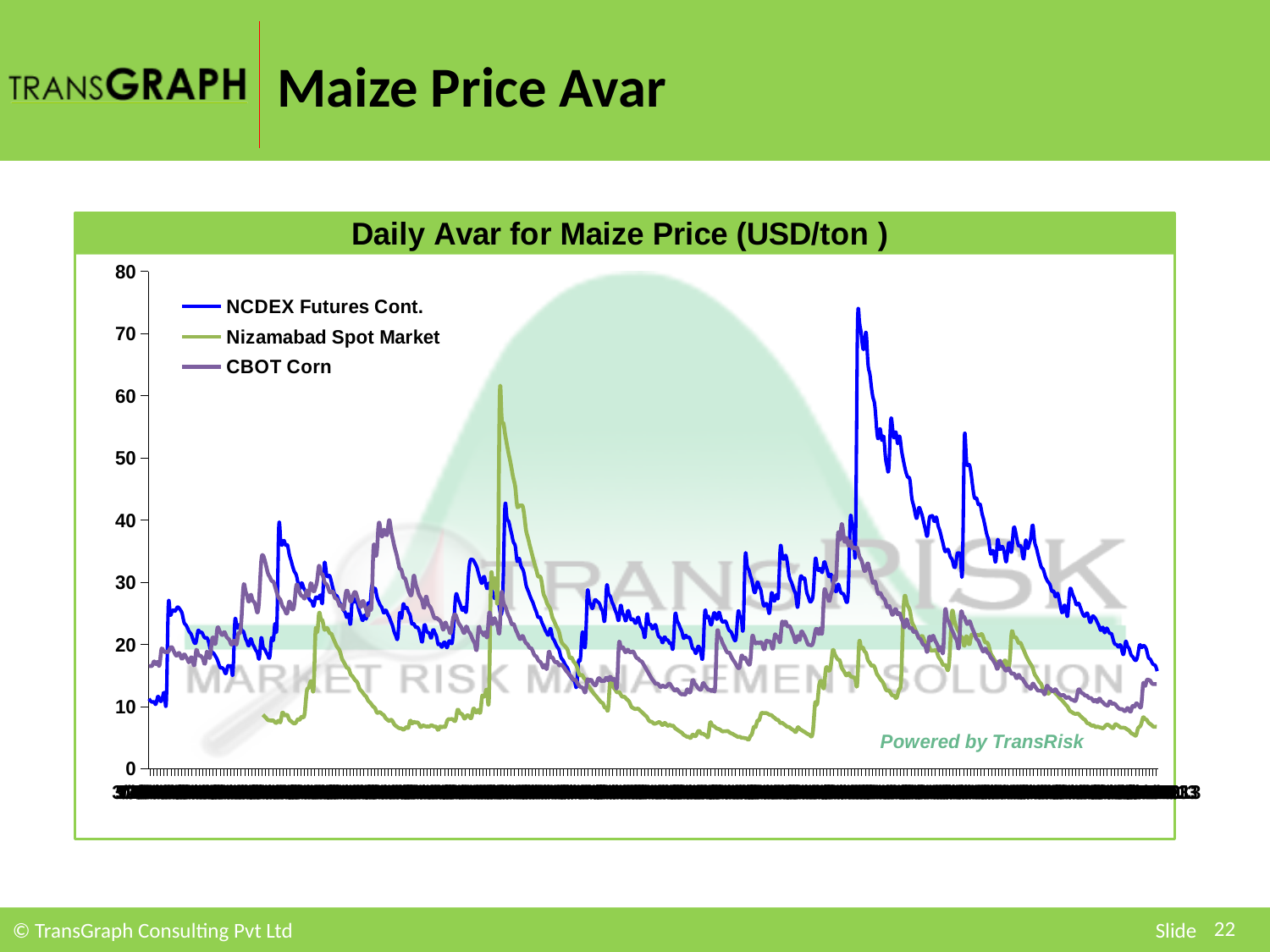
Is the highest peak of the NCDEX Futures Cont. line greater or less than 70? greater Which series reaches the highest value on the chart? NCDEX Futures Cont. How many series does the legend list? 3 What is the title of the chart? Daily Avar for Maize Price (USD/ton ) Is the highest peak of the CBOT Corn line greater or less than 50? less Which series reaches the lowest value on the chart? Nizamabad Spot Market Which series has the higher peak, NCDEX Futures Cont. or CBOT Corn? NCDEX Futures Cont. After its highest peak, does the NCDEX Futures Cont. line generally rise or fall toward the right end of the chart? fall What kind of chart is shown on the slide? line chart Is the lowest point of the Nizamabad Spot Market line greater or less than 10? less Which colour is used for the NCDEX Futures Cont. line? blue